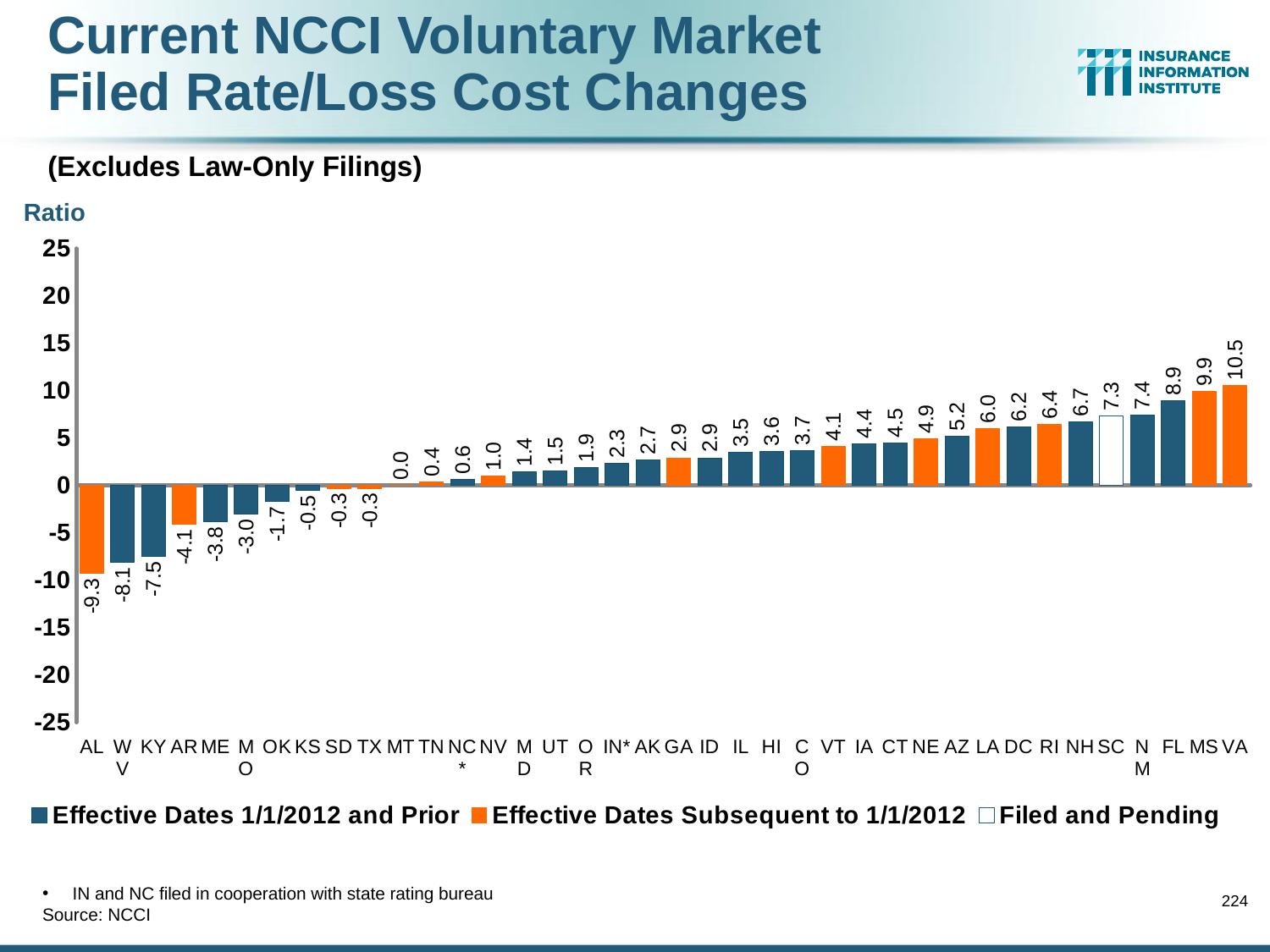
What kind of chart is this? bar chart What is the value for SC? 7.3 How many series does the legend list? 3 What is the value for AL? -9.3 Which state's bar belongs to the 'Filed and Pending' series? SC Which has a larger value, FL or MS? MS How many states are shown on the x axis? 38 Is the value for VA greater or less than 10? greater What is the value for VA? 10.5 Which state has the lowest value? AL Which state has the highest value? VA What is the difference between the values for VA and AL? 19.8